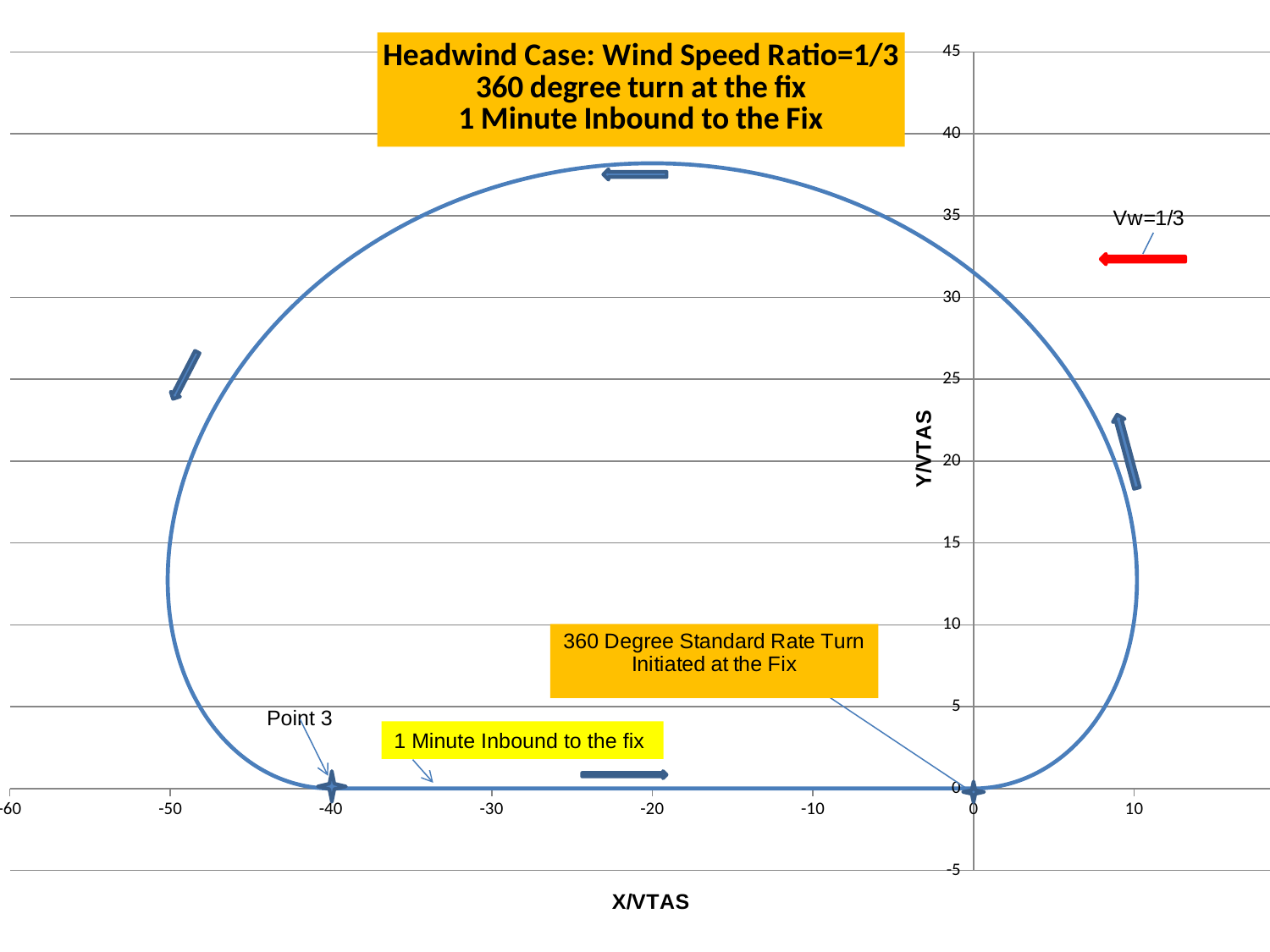
What is the X/VTAS value at the fix where the 360 degree turn is initiated? 0 What is the title of the chart? Headwind Case: Wind Speed Ratio=1/3 360 degree turn at the fix 1 Minute Inbound to the Fix What is the X/VTAS value at the point labelled "Point 3"? -40 What kind of chart is shown on the slide? line chart Is the highest Y/VTAS value reached by the curve greater or less than 35? greater Is the smallest X/VTAS value reached by the curve greater or less than -40? less What is the Y/VTAS value at the point labelled "Point 3"? 0 What wind speed ratio is written next to the red arrow? Vw=1/3 Is the highest Y/VTAS value reached by the curve greater or less than 40? less What is the highest tick value shown on the Y/VTAS axis? 45 What is the label on the horizontal axis of the chart? X/VTAS